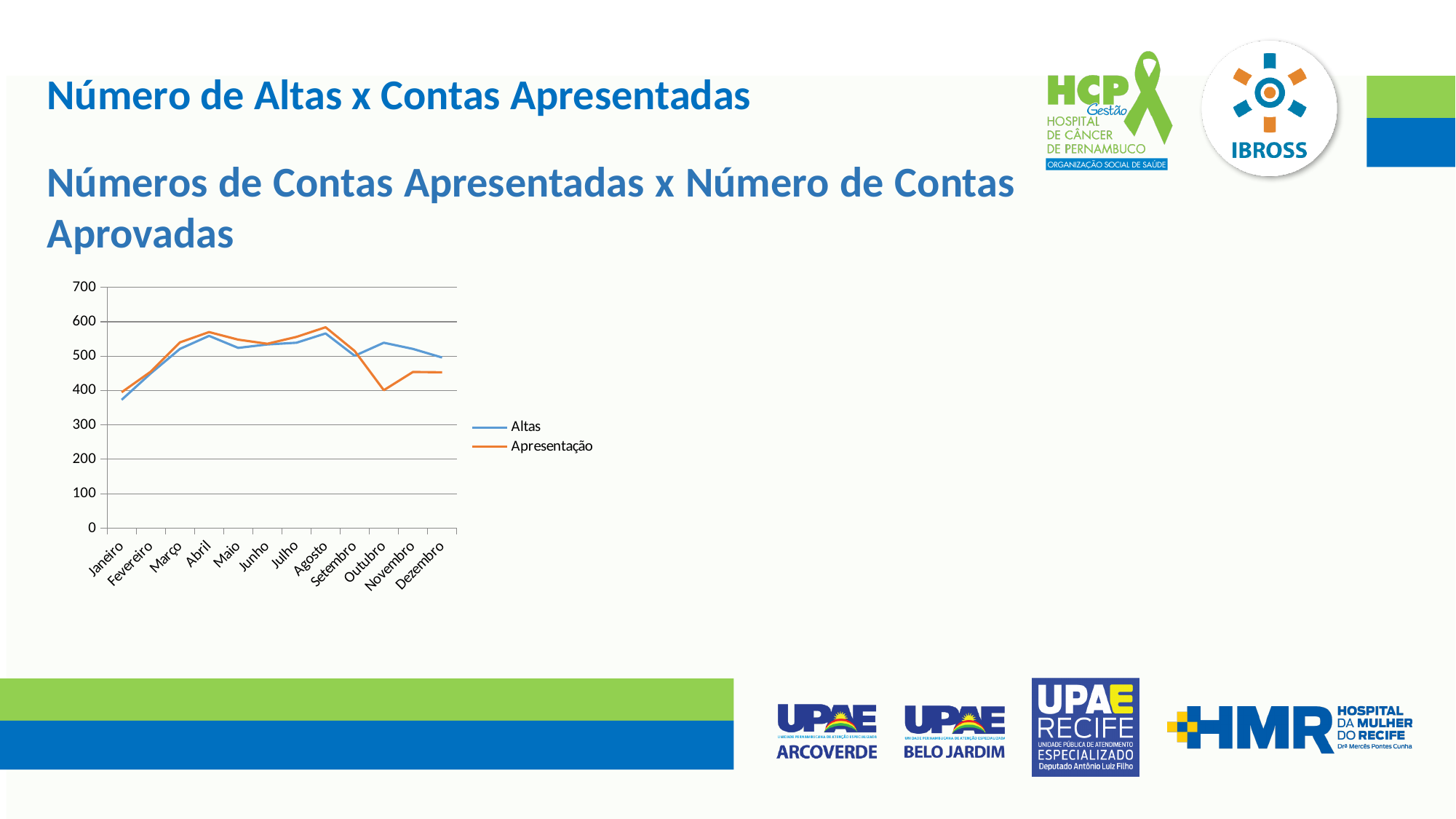
In which month is the Altas series at its lowest value? Janeiro What kind of chart is shown on the slide? line chart In Outubro, which series has the larger value, Altas or Apresentação? Altas Does the Apresentação series rise or fall from Agosto to Outubro? fall Is the value of Altas in Janeiro greater or less than 400? less Is the value of Apresentação in Agosto greater or less than 500? greater Which series are listed in the legend? Altas and Apresentação Is the value of Apresentação in Outubro greater or less than 500? less In which month does the Apresentação series reach its highest value? Agosto How many series does the legend list? 2 What colour is the Apresentação line? orange How many months are plotted along the x axis? 12